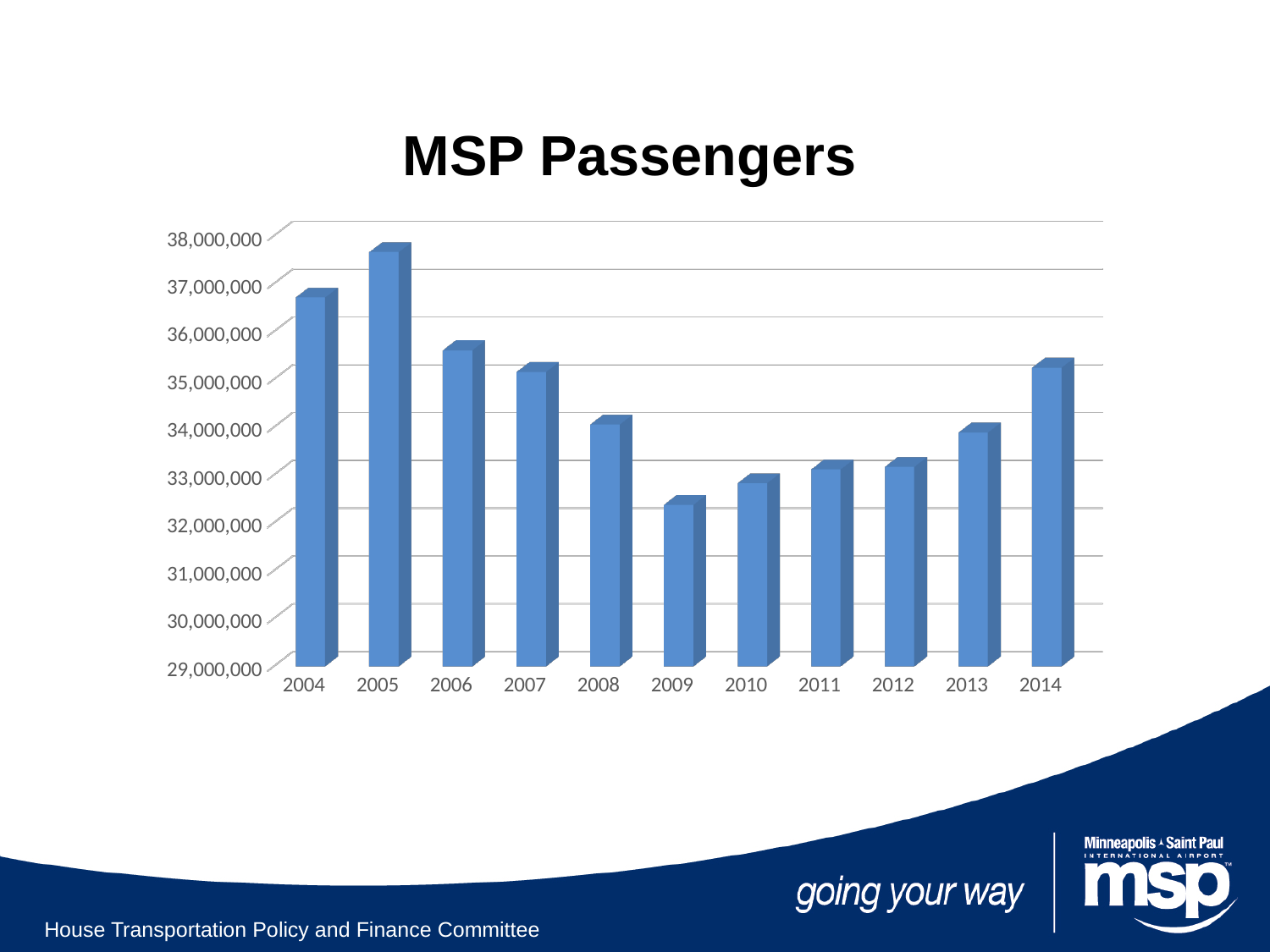
Do the passenger numbers rise or fall from 2009 to 2014? rise Which year has more passengers, 2004 or 2014? 2004 Is the value for 2004 greater or less than 36,000,000? greater Is the value for 2005 greater or less than 37,000,000? greater What kind of chart is shown on the slide? bar chart Which year has the highest number of MSP passengers? 2005 Which year has more passengers, 2006 or 2013? 2006 What is the title of the chart? MSP Passengers Which year has the lowest number of MSP passengers? 2009 Is the value for 2009 greater or less than 33,000,000? less How many years are shown on the x axis of the chart? 11